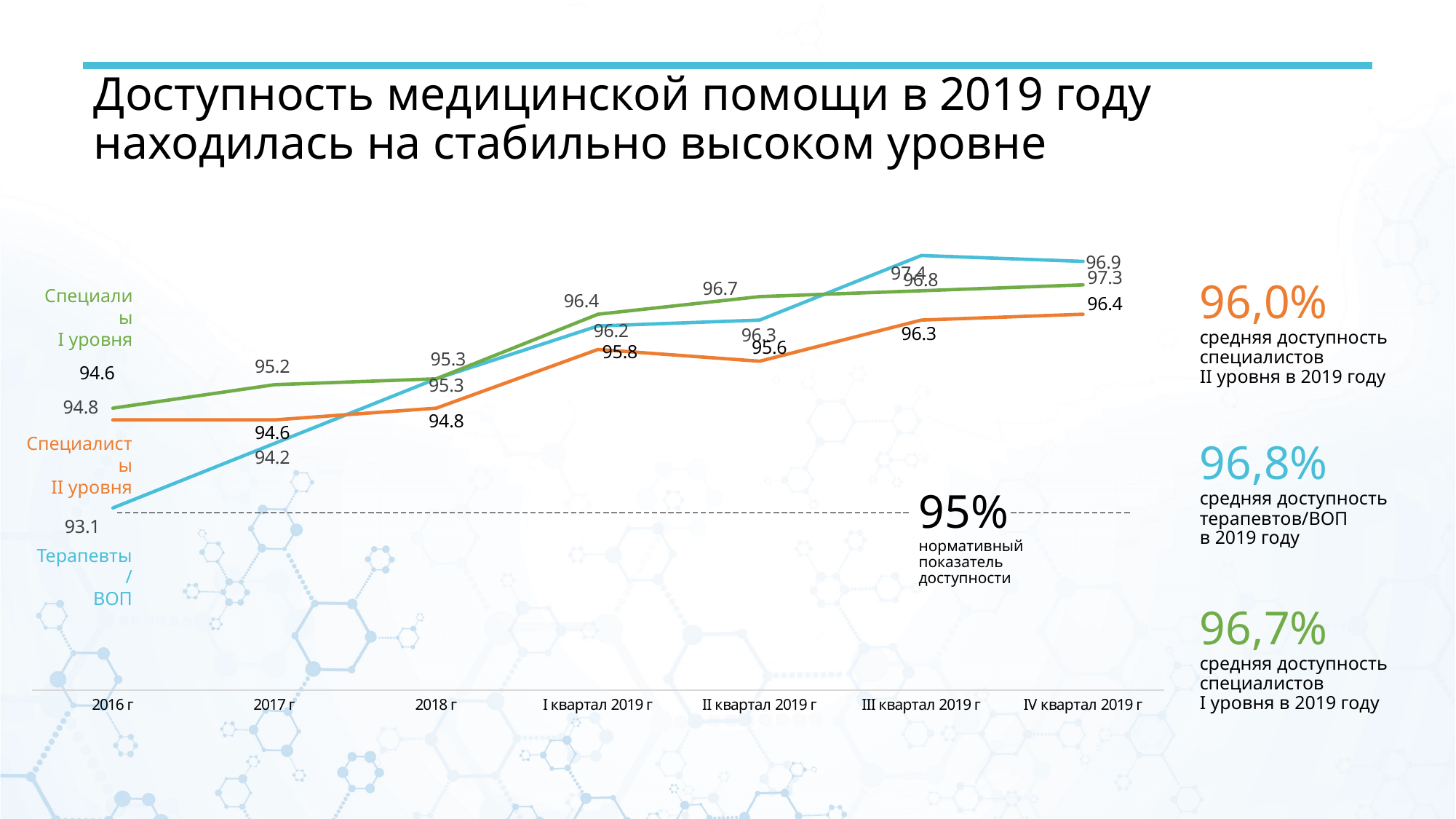
In IV квартал 2019 г, which is higher: Специалисты I уровня or Терапевты/ВОП? Терапевты/ВОП Is the value for Терапевты/ВОП in 2016 г greater or less than 95? less What is the value for Специалисты II уровня in 2017 г? 94.6 What is the difference between the Терапевты/ВОП values in III квартал 2019 г and IV квартал 2019 г? 0.1 How many points are there along the x axis of the chart? 7 How many series (lines) are plotted on the chart? 3 What type of chart is shown on the slide? line chart At which point on the x axis does the Терапевты/ВОП line reach its highest value? III квартал 2019 г What is the value for Специалисты II уровня in IV квартал 2019 г? 96.4 What is the value for Специалисты I уровня in II квартал 2019 г? 96.7 What is the average availability of терапевты/ВОП in 2019 shown on the right of the slide? 96,8% What is the value for Терапевты/ВОП in 2016 г? 93.1